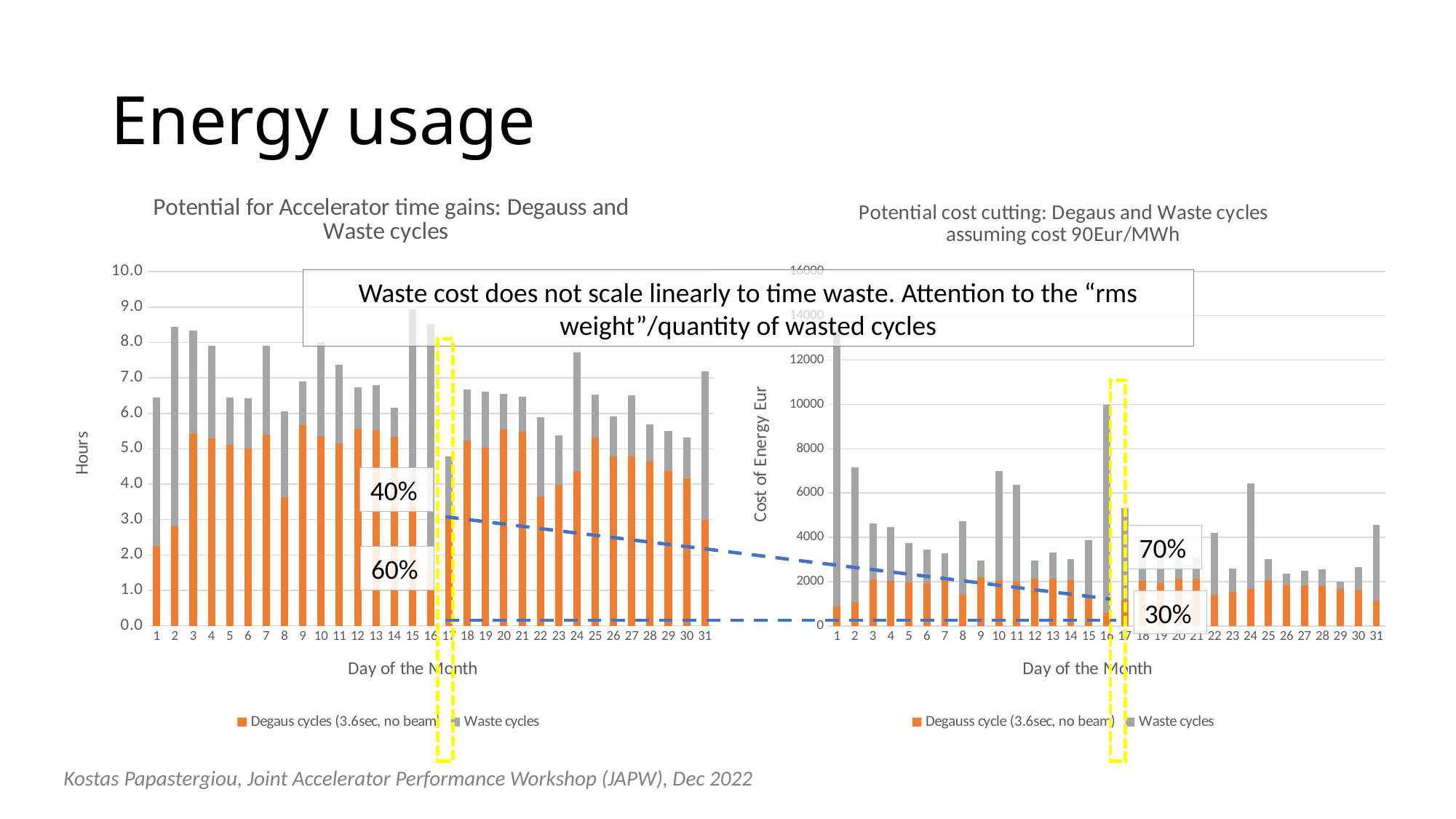
In the right chart, 'Potential cost cutting', which day has the highest total bar? 1 In the right chart, is the total value for day 1 greater or less than 12000? greater How many days are plotted on the x axis of the right chart, 'Potential cost cutting'? 31 What kind of chart is the left chart, 'Potential for Accelerator time gains: Degauss and Waste cycles'? Stacked bar chart In the left chart, 'Potential for Accelerator time gains', which day has the highest total bar? 15 In the left chart, which day has the larger total bar, day 2 or day 17? Day 2 How many series does the legend of the left chart list? 2 In the left chart, 'Potential for Accelerator time gains', which day has the lowest total bar? 17 In the left chart, is the total value for day 17 greater or less than 5.0? less What is the y-axis label of the right chart, 'Potential cost cutting'? Cost of Energy Eur What are the two legend entries of the right chart, 'Potential cost cutting'? Degauss cycle (3.6sec, no beam) and Waste cycles In the right chart, is the total value for day 10 greater or less than 6000? greater